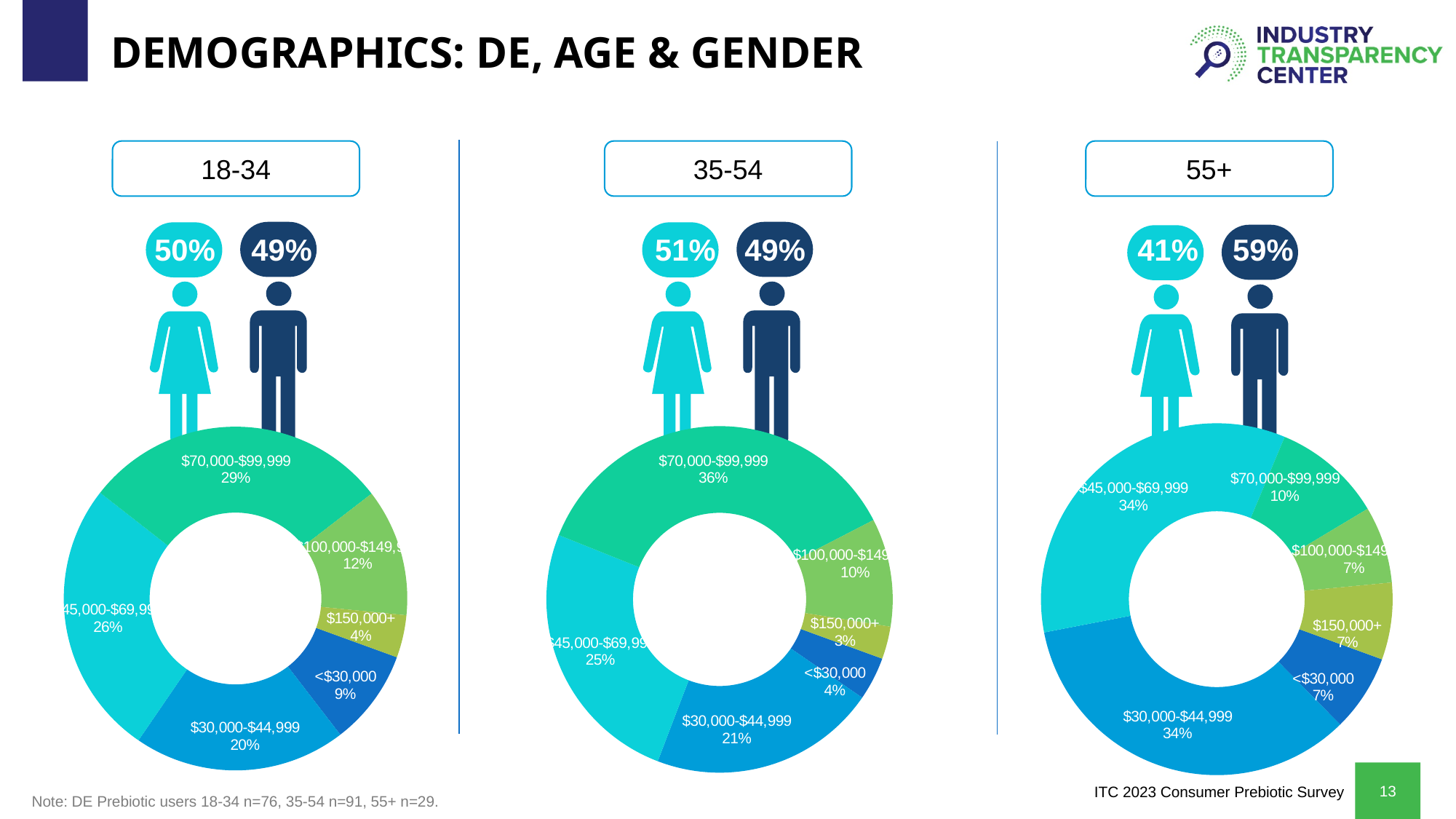
In the 18-34 chart, what is the combined share of the $100,000-$149,999 and $150,000+ brackets? 16% In the 35-54 chart, what share of respondents have an income under $30,000? 4% What type of chart is used to show the income distribution for each age group? Donut chart In the 35-54 chart, what share of respondents have an income of $30,000-$44,999? 21% What percentage of the 55+ group is male? 59% In the 35-54 chart, which income bracket has the smallest share? $150,000+ In the 18-34 chart, what share of respondents have an income of $70,000-$99,999? 29% In the 55+ chart, which is larger: the share for $70,000-$99,999 or the share for $30,000-$44,999? $30,000-$44,999 In the 18-34 chart, what is the difference between the $45,000-$69,999 share and the $30,000-$44,999 share? 6% In the 18-34 chart, which income bracket has the largest share? $70,000-$99,999 How many income brackets are shown in the 35-54 chart? 6 In the 55+ chart, what share of respondents have an income of $45,000-$69,999? 34%